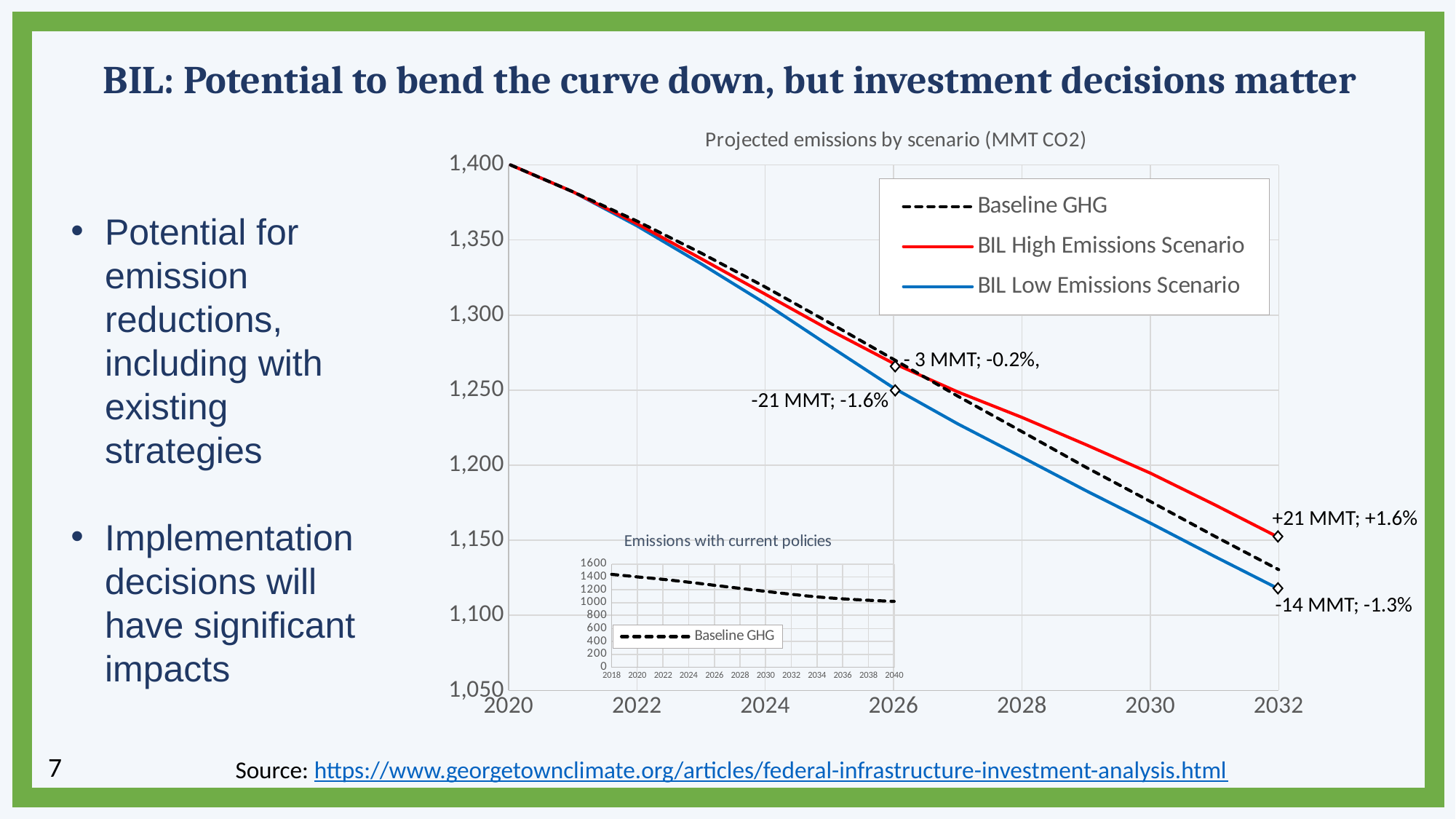
In the 'Projected emissions by scenario (MMT CO2)' chart, is the BIL High Emissions Scenario value in 2032 greater or less than 1,200? less In the 'Projected emissions by scenario (MMT CO2)' chart, is the BIL Low Emissions Scenario value in 2032 greater or less than 1,150? less In the 'Projected emissions by scenario (MMT CO2)' chart, do the emissions values rise or fall from 2020 to 2032? fall How many series does the legend of the 'Projected emissions by scenario (MMT CO2)' chart list? 3 In the 'Projected emissions by scenario (MMT CO2)' chart, what data label is shown for the BIL High Emissions Scenario at 2032? +21 MMT; +1.6% How many series does the legend of the inset 'Emissions with current policies' chart list? 1 In the 'Projected emissions by scenario (MMT CO2)' chart, what data label is shown for the BIL Low Emissions Scenario at 2032? -14 MMT; -1.3% In the 'Projected emissions by scenario (MMT CO2)' chart, what data label is shown for the BIL Low Emissions Scenario at 2026? -21 MMT; -1.6% What kind of chart is the 'Projected emissions by scenario (MMT CO2)' chart? line chart In the 'Projected emissions by scenario (MMT CO2)' chart, what data label is shown for the BIL High Emissions Scenario at 2026? -3 MMT; -0.2% In the 'Projected emissions by scenario (MMT CO2)' chart, which series is drawn as a dashed black line? Baseline GHG In the 'Projected emissions by scenario (MMT CO2)' chart, which scenario has the lowest value in 2032? BIL Low Emissions Scenario